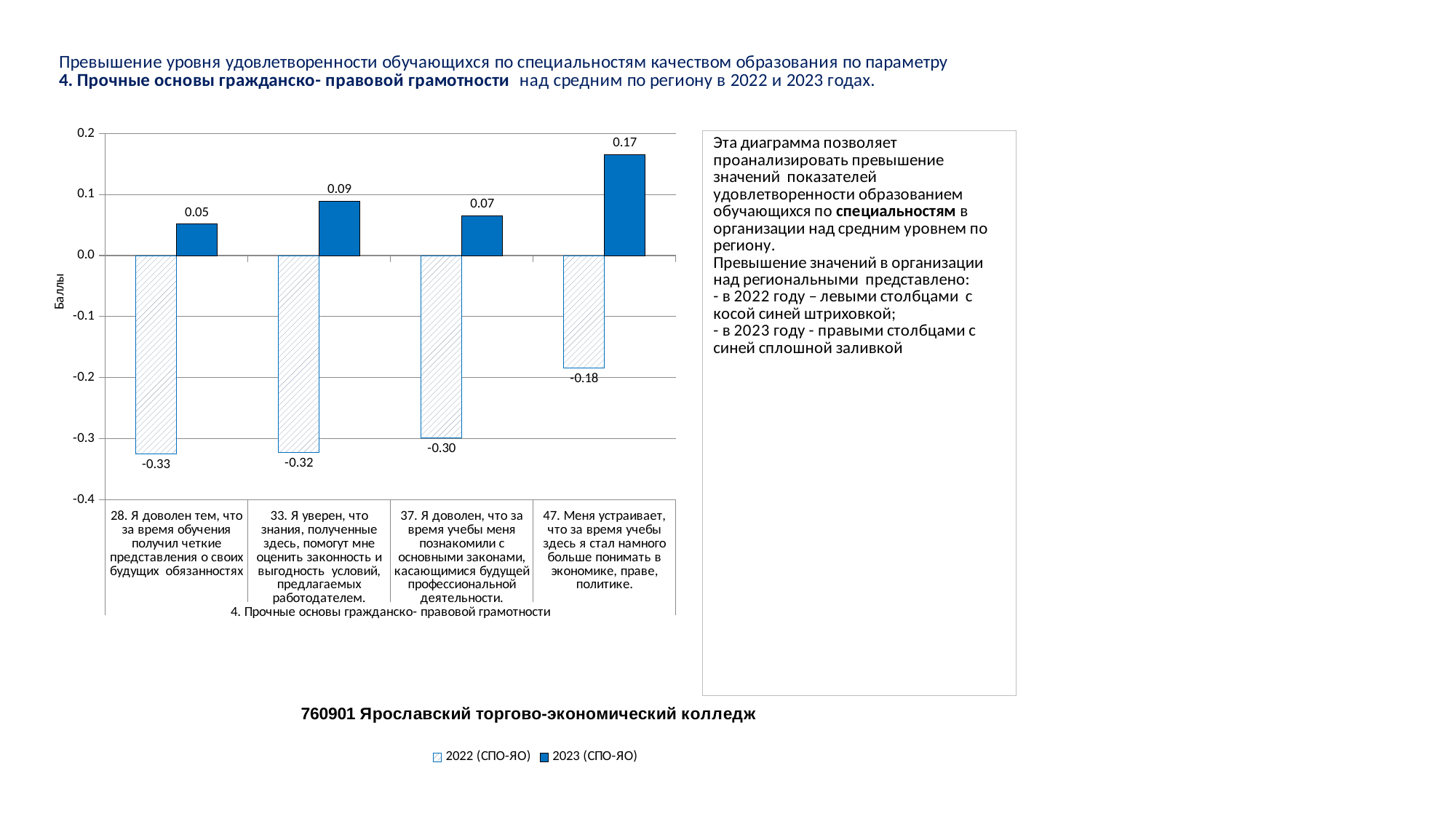
What is the 2022 (СПО-ЯО) value for category 37 (Я доволен, что за время учебы меня познакомили с основными законами)? -0.30 What is the label of the vertical axis of the chart? Баллы How many series does the chart legend list? 2 Which category has the highest 2023 (СПО-ЯО) value? 47. Меня устраивает, что за время учебы здесь я стал намного больше понимать в экономике, праве, политике. What is the difference between the 2023 and 2022 values for category 47? 0.35 Which is larger for category 33: the 2022 (СПО-ЯО) value or the 2023 (СПО-ЯО) value? 2023 (СПО-ЯО) What is the 2023 (СПО-ЯО) value for category 47 (Меня устраивает, что за время учебы здесь я стал намного больше понимать в экономике, праве, политике)? 0.17 What is the 2023 (СПО-ЯО) value for category 33 (Я уверен, что знания, полученные здесь, помогут мне оценить законность и выгодность условий)? 0.09 What is the 2022 (СПО-ЯО) value for category 28 (Я доволен тем, что за время обучения получил четкие представления о своих будущих обязанностях)? -0.33 What type of chart is shown on the slide? Bar chart How many categories are shown on the x axis of the chart? 4 Which category has the lowest 2022 (СПО-ЯО) value? 28. Я доволен тем, что за время обучения получил четкие представления о своих будущих обязанностях